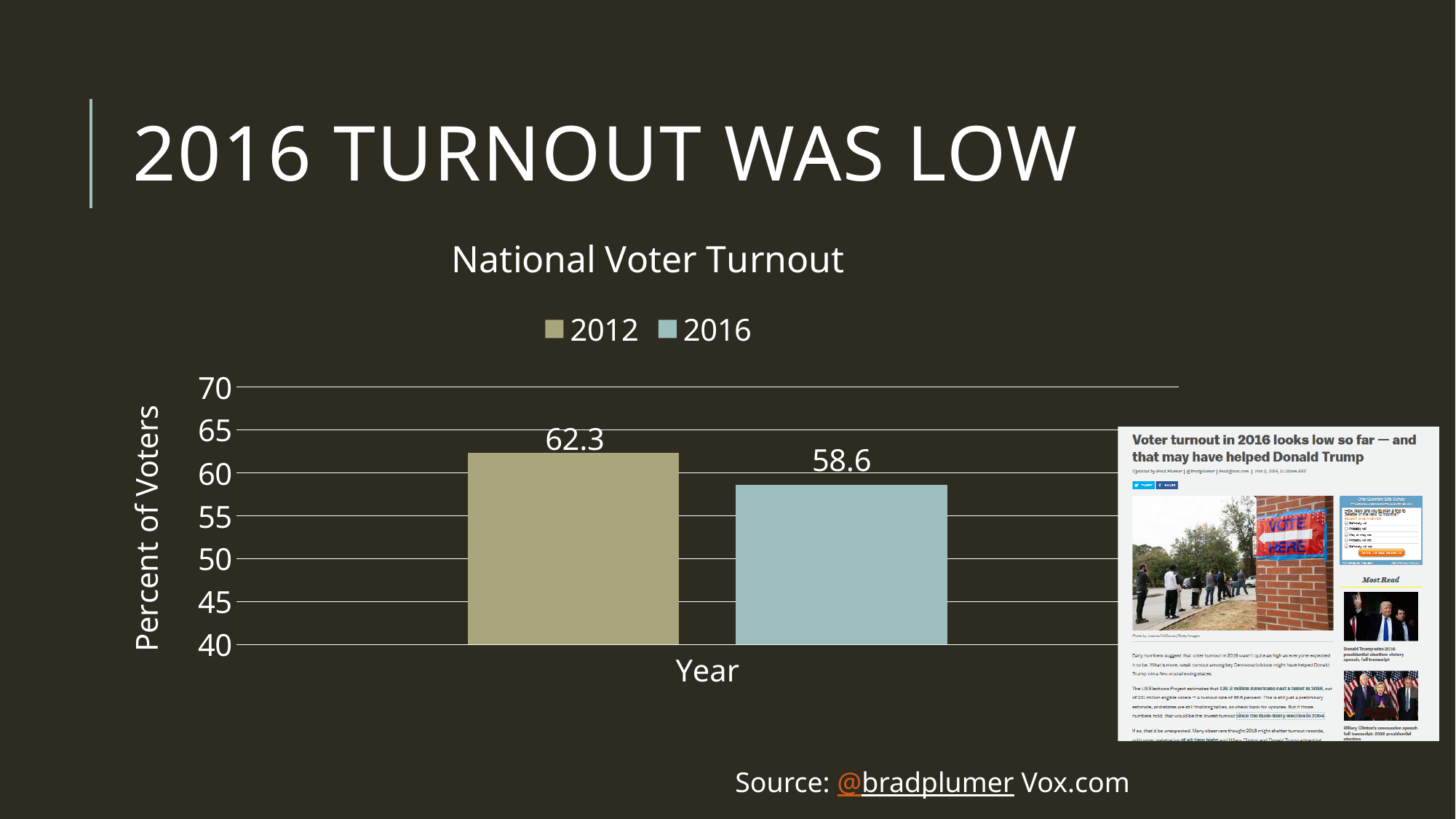
How many series does the legend list? 2 What is the label on the vertical axis of the chart? Percent of Voters Is the turnout for 2012 greater or less than 60? greater What is the voter turnout value shown for 2016? 58.6 What is the voter turnout value shown for 2012? 62.3 Which year has the higher voter turnout? 2012 What is the title of the chart? National Voter Turnout Is the turnout for 2016 greater or less than 60? less Does voter turnout rise or fall from 2012 to 2016? fall Which year has the lower voter turnout? 2016 What kind of chart is shown on the slide? bar chart What is the difference between the 2012 and 2016 turnout values? 3.7